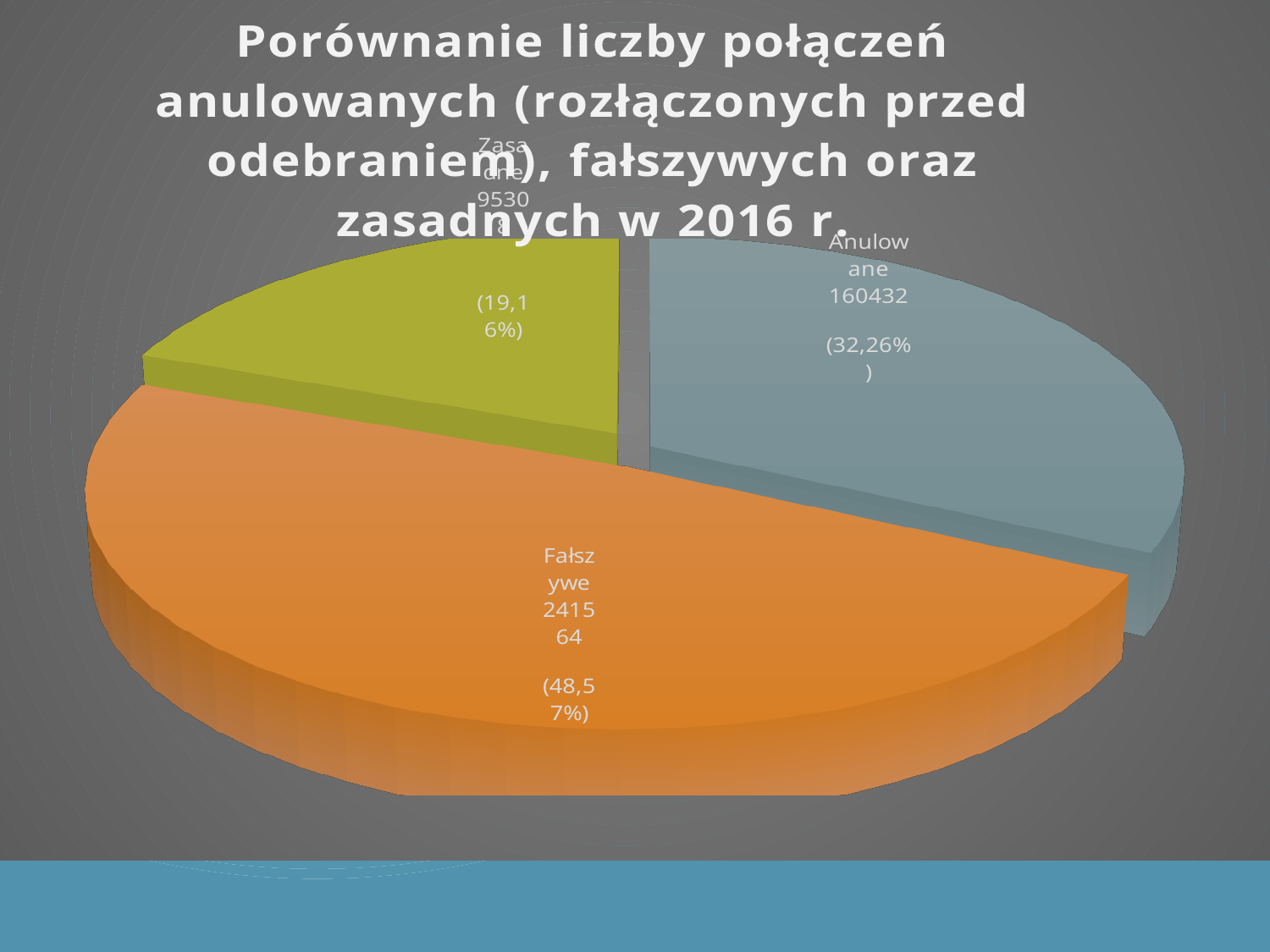
What is the value shown for Anulowane? 160432 Which category has the smallest slice of the pie? Zasadne What share of the pie does Fałszywe represent? 48,57% What kind of chart is shown on the slide? pie chart Which is larger, the slice for Anulowane or the slice for Zasadne? Anulowane What is the value shown for Fałszywe? 241564 What colour is the Fałszywe slice? orange Which category has the largest slice of the pie? Fałszywe How many slices does the pie chart have? 3 What is the difference between the values for Fałszywe and Anulowane? 81132 What share of the pie does Zasadne represent? 19,16% What share of the pie does Anulowane represent? 32,26%